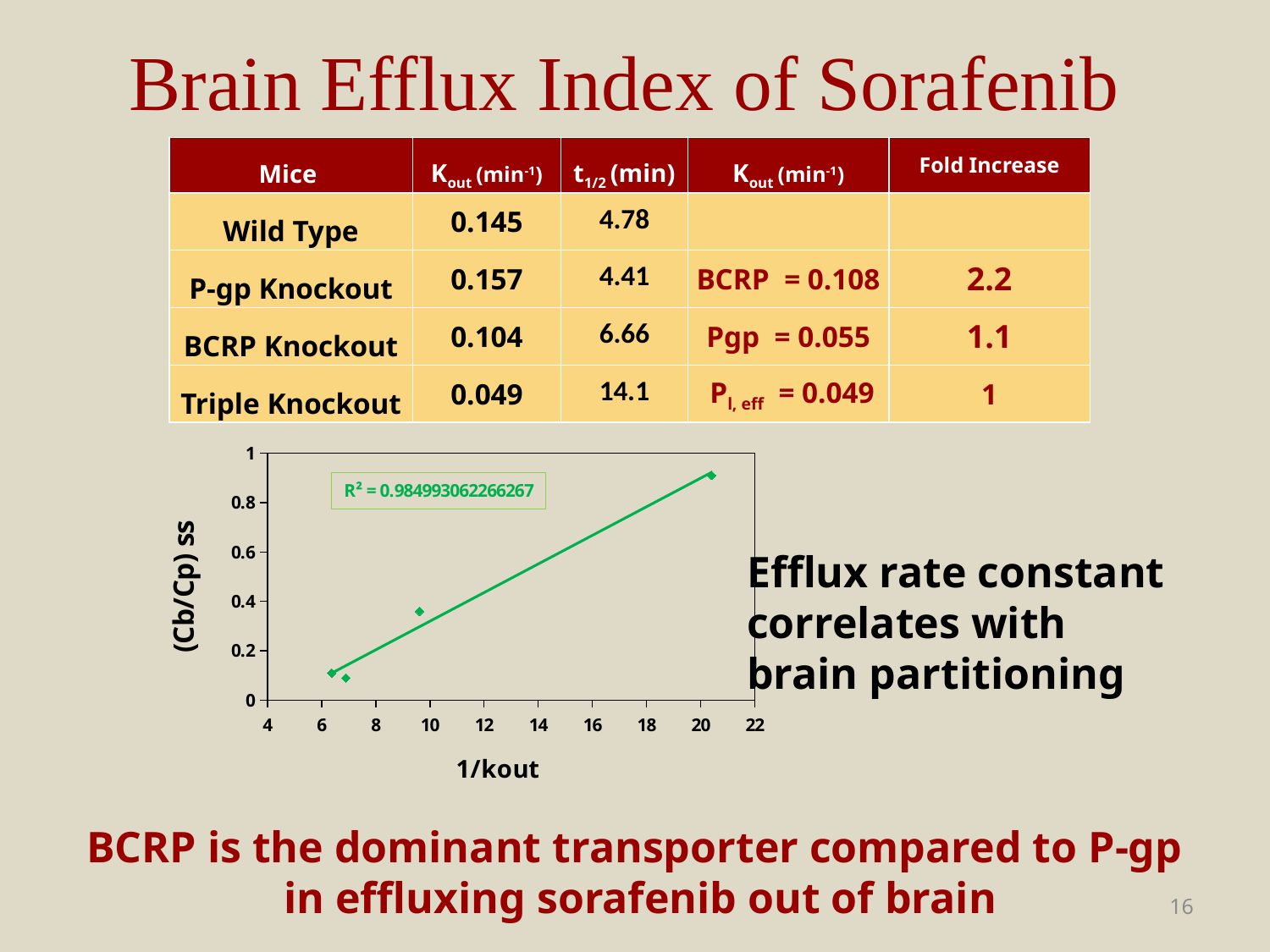
Is the (Cb/Cp) ss value of the data point near 1/kout = 10 greater or less than 0.2? greater What R² value is printed on the chart? R² = 0.984993062266267 How many data points are plotted in the scatter chart? 4 Is the (Cb/Cp) ss value of the data point near 1/kout = 10 greater or less than 0.4? less Which has the larger (Cb/Cp) ss value: the data point near 1/kout = 10 or the data point near 1/kout = 20? the point near 1/kout = 20 Is the (Cb/Cp) ss value of the rightmost data point greater or less than 0.8? greater What kind of chart is shown on the slide? scatter chart What is the label of the x axis of the chart? 1/kout Do the plotted values rise or fall as 1/kout increases along the x axis? rise